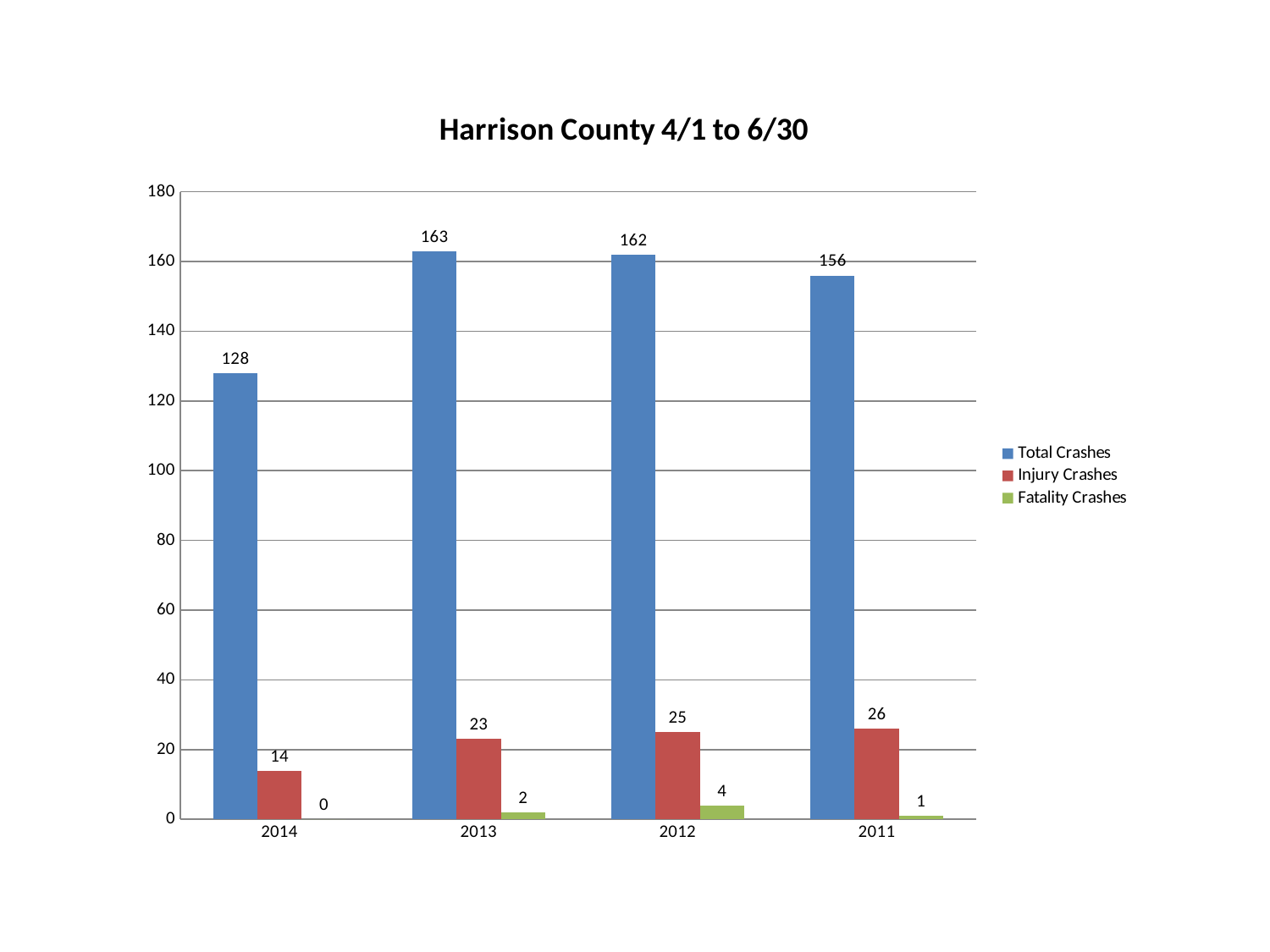
Which year has the lowest Injury Crashes? 2014 Which is larger, Injury Crashes in 2011 or Injury Crashes in 2013? 2011 What is the title of the chart? Harrison County 4/1 to 6/30 What is the value of Injury Crashes for 2012? 25 How many series does the legend list? 3 What is the value of Fatality Crashes for 2013? 2 What kind of chart is shown on the slide? bar chart Which year has the highest Total Crashes? 2013 Is the value of Total Crashes for 2011 greater or less than 140? greater What is the difference between Total Crashes in 2013 and 2014? 35 What is the value of Total Crashes for 2014? 128 How many years are shown on the x axis? 4